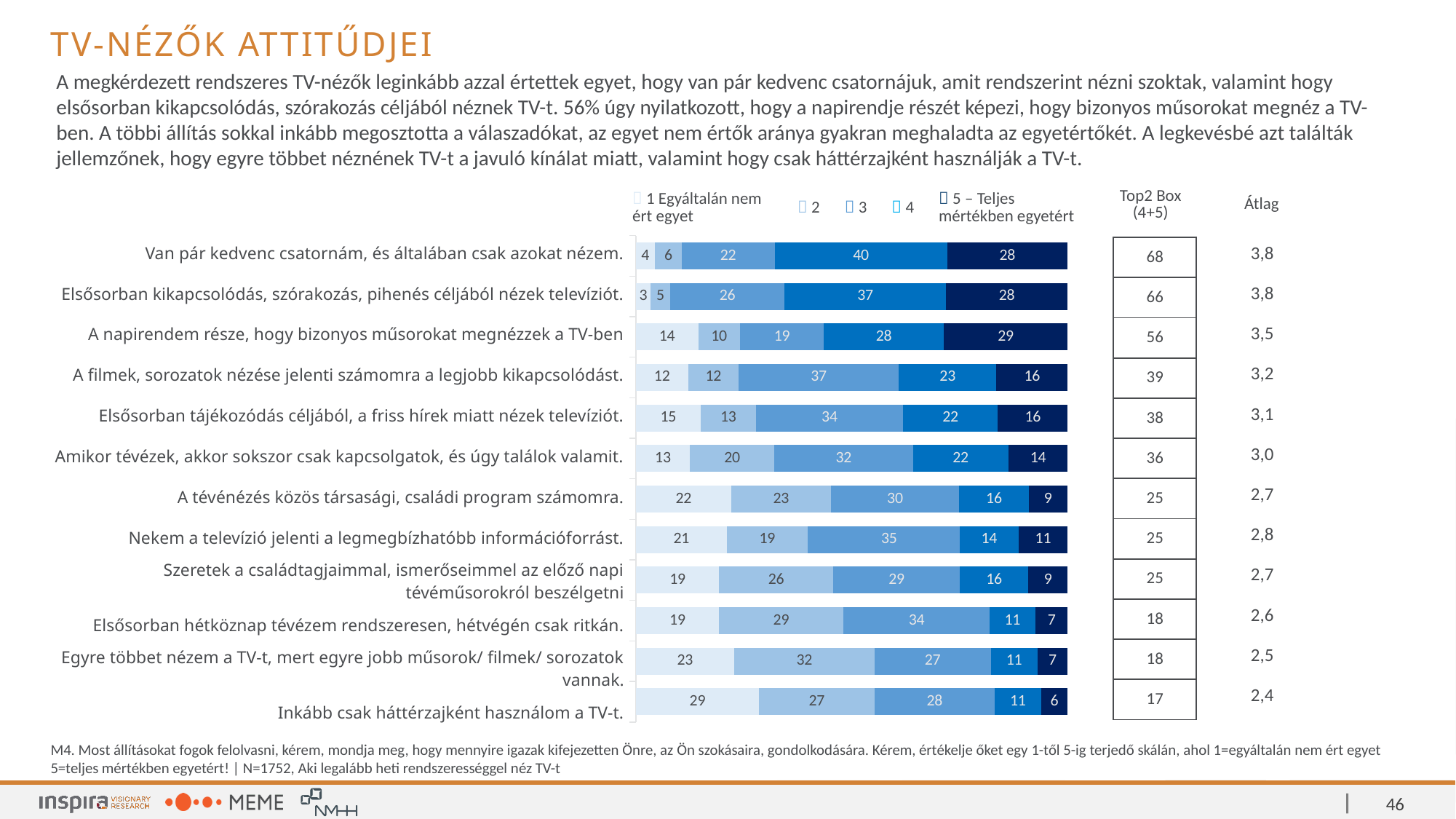
Which has the larger series "4" value: "Van pár kedvenc csatornám, és általában csak azokat nézem." or "Elsősorban kikapcsolódás, szórakozás, pihenés céljából nézek televíziót."? Van pár kedvenc csatornám, és általában csak azokat nézem. What is the total of the stacked bar for "A napirendem része, hogy bizonyos műsorokat megnézzek a TV-ben"? 100 Which statement has the highest value for "1 Egyáltalán nem ért egyet"? Inkább csak háttérzajként használom a TV-t. Which statement has the lowest value for "5 – Teljes mértékben egyetért"? Inkább csak háttérzajként használom a TV-t. What is the difference between the series "3" value for "A filmek, sorozatok nézése jelenti számomra a legjobb kikapcsolódást." and for "A tévénézés közös társasági, családi program számomra."? 7 What is the first entry in the chart's legend? 1 Egyáltalán nem ért egyet How many statements (categories) are plotted in the chart? 12 What kind of chart is shown on the slide? bar chart What is the value of series "2" for "Egyre többet nézem a TV-t, mert egyre jobb műsorok/ filmek/ sorozatok vannak."? 32 What is the value of "5 – Teljes mértékben egyetért" for "Van pár kedvenc csatornám, és általában csak azokat nézem."? 28 How many series does the chart's legend list? 5 What is the value of "1 Egyáltalán nem ért egyet" for "Inkább csak háttérzajként használom a TV-t."? 29